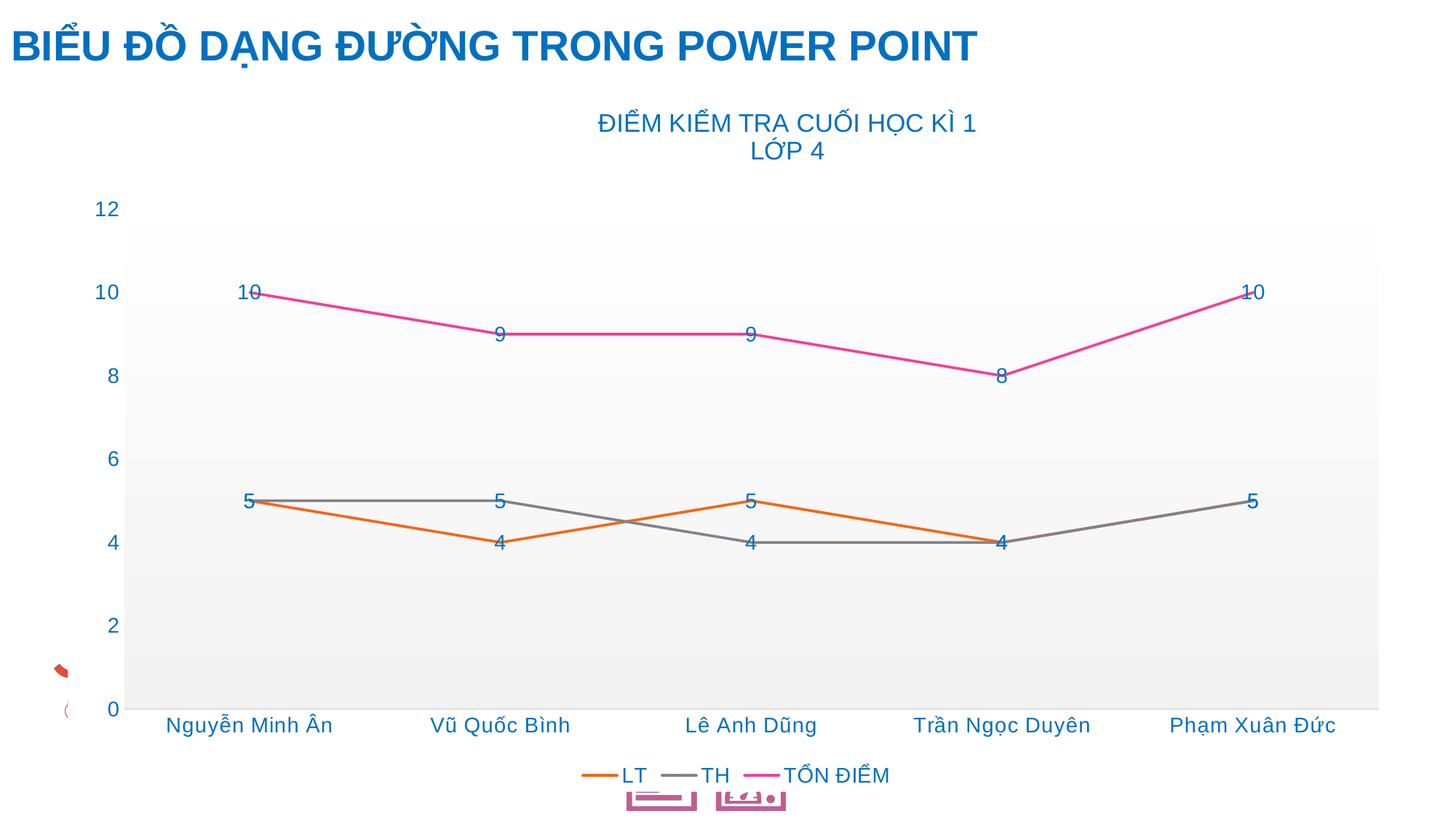
Which student has the lowest TỔNG ĐIỂM? Trần Ngọc Duyên Is the TỔNG ĐIỂM value for Lê Anh Dũng greater or less than 8? greater What is the LT value for Lê Anh Dũng? 5 What is the difference between the TỔNG ĐIỂM of Nguyễn Minh Ân and Trần Ngọc Duyên? 2 What is the title of the chart? ĐIỂM KIỂM TRA CUỐI HỌC KÌ 1 LỚP 4 What is the TỔNG ĐIỂM value for Trần Ngọc Duyên? 8 What is the TH value for Vũ Quốc Bình? 5 How many students are shown on the x axis? 5 How many series does the legend list? 3 What type of chart is shown on the slide? line chart What is the TỔNG ĐIỂM value for Vũ Quốc Bình? 9 Which is larger, the LT value for Vũ Quốc Bình or the TH value for Vũ Quốc Bình? TH